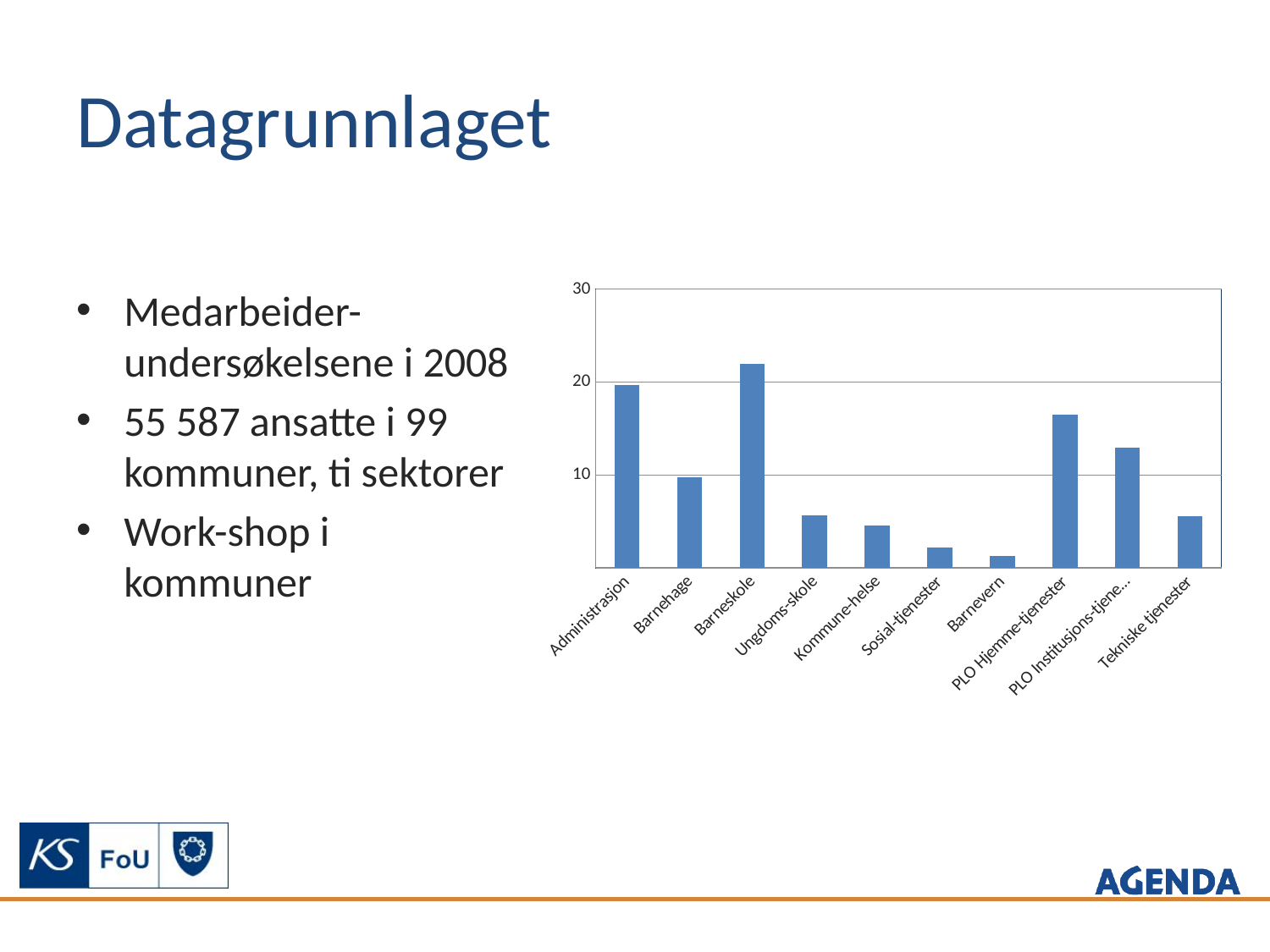
What colour are the bars in the chart? blue What kind of chart is shown on the slide? bar chart Is the value for PLO Hjemme-tjenester greater or less than 10? greater Which category has the highest bar in the chart? Barneskole Which is larger, the value for Administrasjon or the value for Barnehage? Administrasjon What is the highest value shown on the y axis of the chart? 30 How many categories are shown on the x axis of the chart? 10 Is the value for Barneskole greater or less than 20? greater Which is larger, the value for PLO Hjemme-tjenester or the value for PLO Institusjons-tjenester? PLO Hjemme-tjenester Which category has the lowest bar in the chart? Barnevern Is the value for Sosial-tjenester greater or less than 10? less